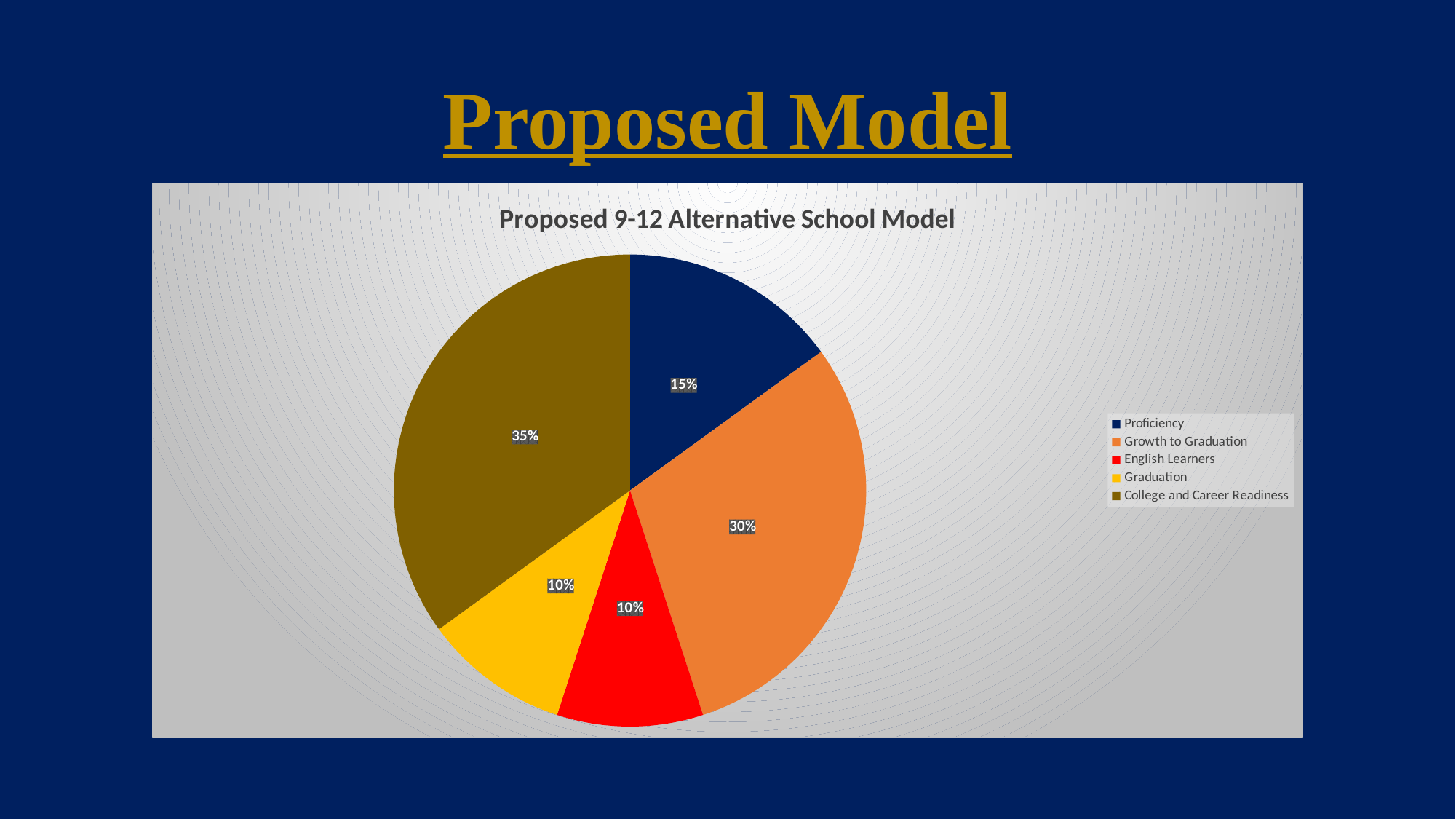
What colour is the Graduation slice? Yellow What kind of chart is shown on the slide? Pie chart Which category has the largest slice of the pie? College and Career Readiness What percentage is shown for English Learners? 10% What is the difference between the College and Career Readiness share and the Proficiency share? 20% How many slices does the pie chart have? 5 What is the combined share of Proficiency and Growth to Graduation? 45% What percentage is shown for Proficiency? 15% What percentage is shown for Growth to Graduation? 30% Which is larger, the share for Growth to Graduation or the share for Proficiency? Growth to Graduation What percentage is shown for College and Career Readiness? 35% What is the title of the chart? Proposed 9-12 Alternative School Model